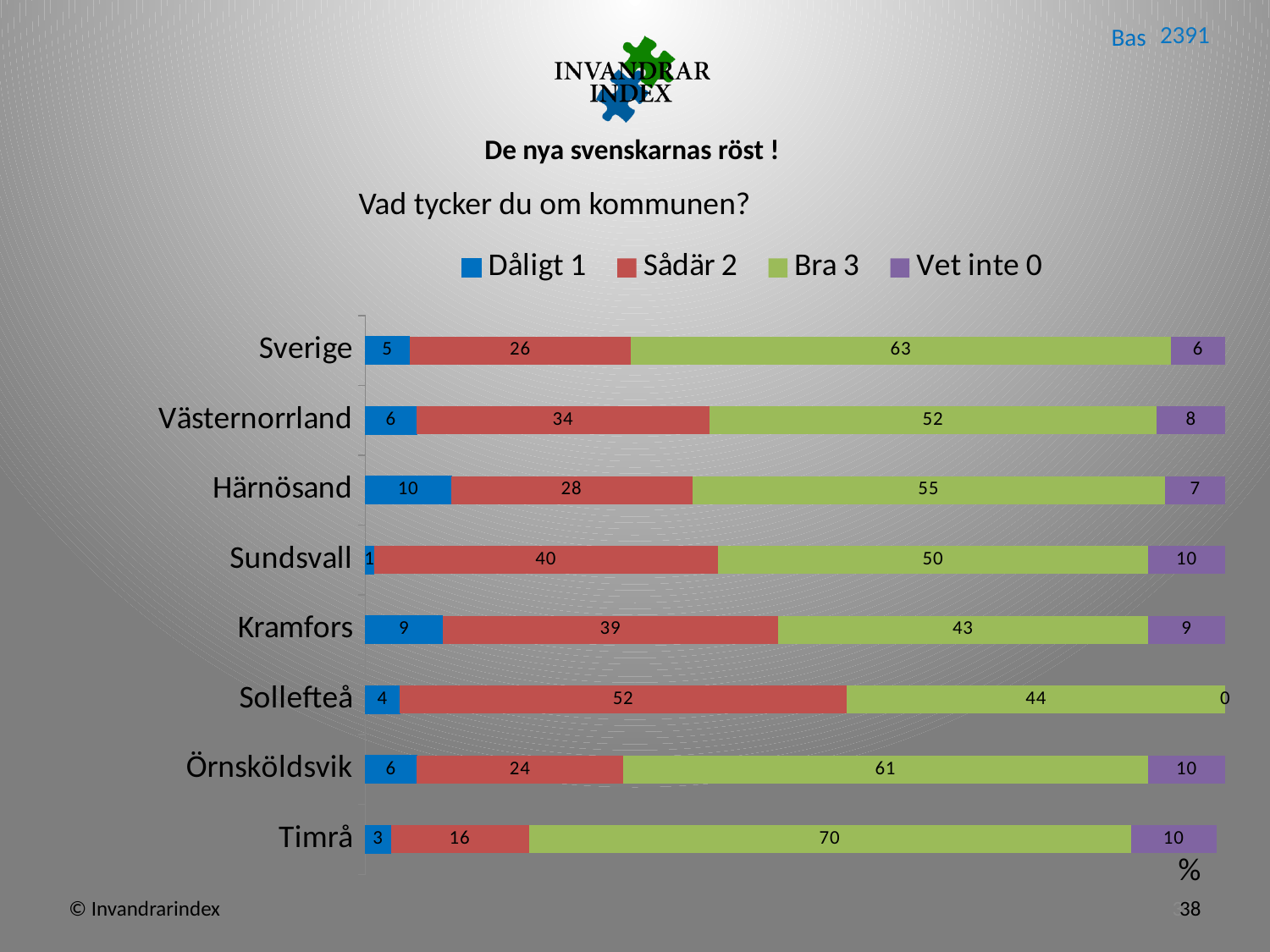
What is the total of the stacked bar for Sundsvall? 101 What is the value of "Dåligt 1" for Härnösand? 10 How many series does the legend list? 4 Which is larger: the "Bra 3" value for Kramfors or for Sollefteå? Sollefteå What kind of chart is shown on the slide? Stacked bar chart What is the value of "Sådär 2" for Sollefteå? 52 How many categories are shown on the chart? 8 What is the value of "Vet inte 0" for Västernorrland? 8 Which category has the lowest value for "Dåligt 1"? Sundsvall Which category has the highest value for "Bra 3"? Timrå What is the difference between the "Sådär 2" values for Sundsvall and Sverige? 14 What is the value of "Bra 3" for Timrå? 70